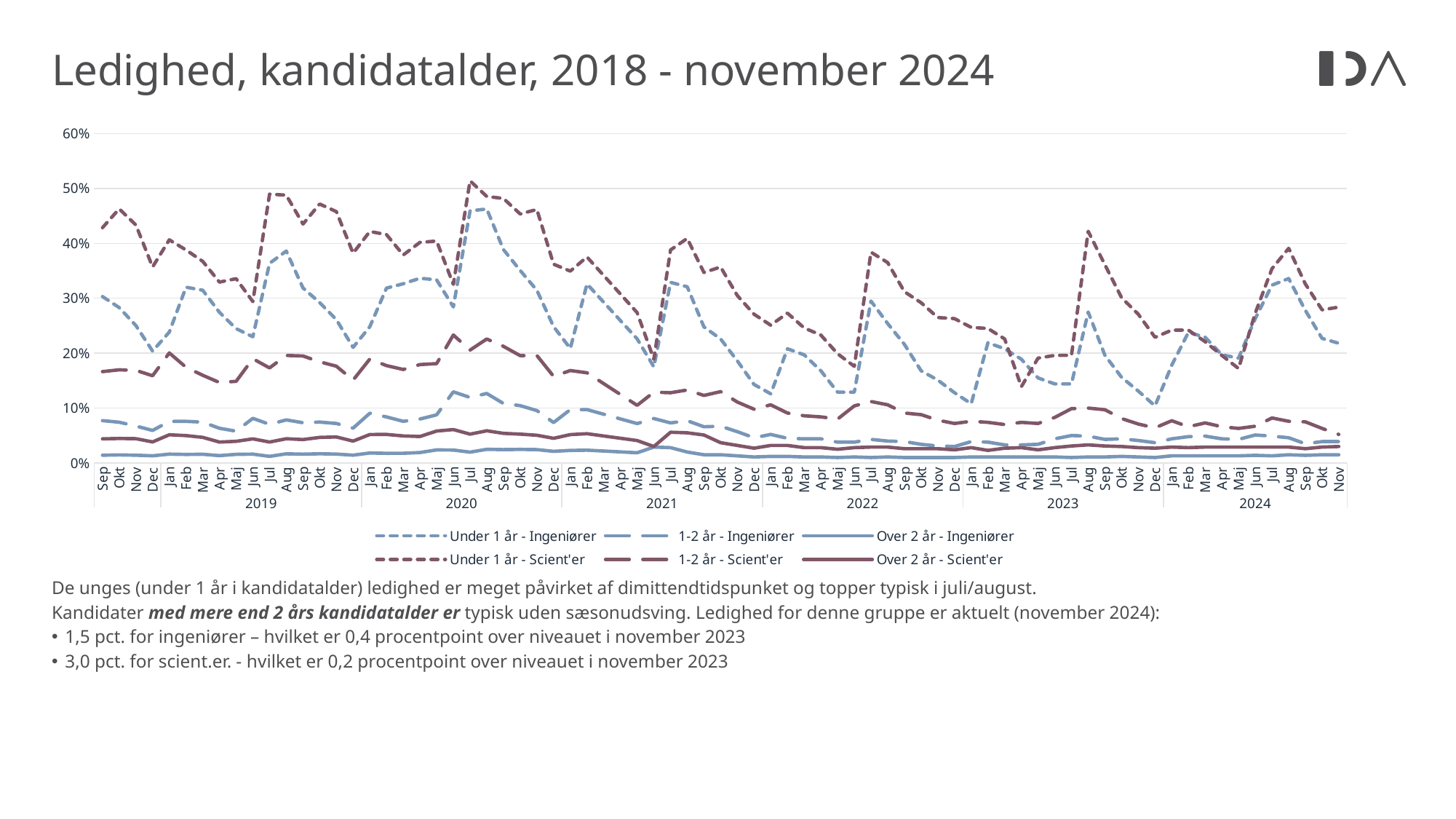
Is the value for Over 2 år - Ingeniører in Nov 2024 greater or less than 10%? less How many series does the legend list? 6 Which series stays lowest across the whole chart? Over 2 år - Ingeniører Is the value for Under 1 år - Ingeniører in Jul 2020 greater or less than 40%? greater How many year labels appear along the x axis? 6 Does the Under 1 år - Scient'er line rise or fall from Aug 2024 to Nov 2024? fall Is the value for Under 1 år - Ingeniører in Dec 2023 greater or less than 20%? less What kind of chart is shown on the slide? line chart What is the title of the chart? Ledighed, kandidatalder, 2018 - november 2024 Which series reaches the highest value anywhere on the chart? Under 1 år - Scient'er In Jul 2020, which is higher: Under 1 år - Scient'er or Under 1 år - Ingeniører? Under 1 år - Scient'er